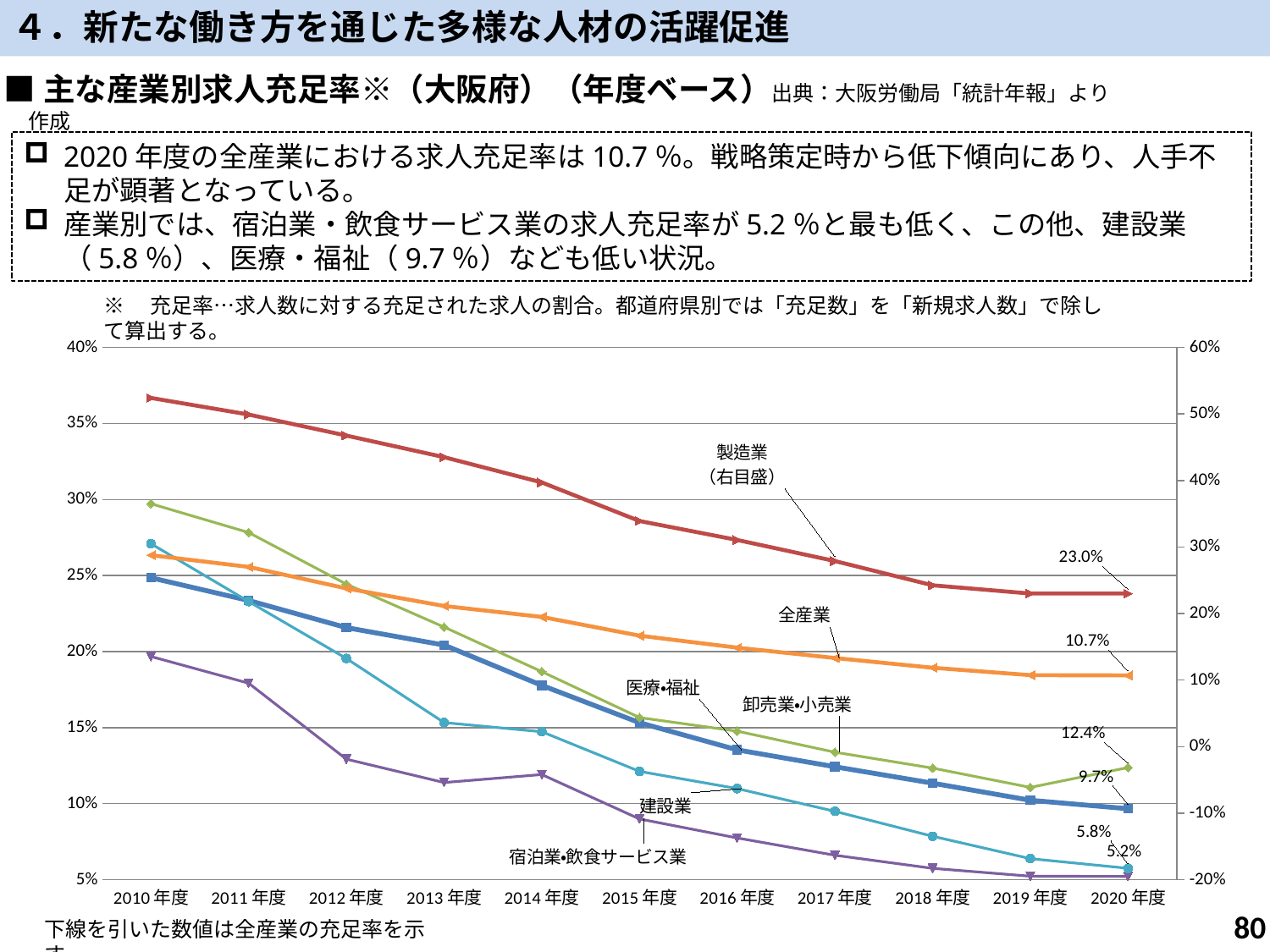
What is the value for 製造業 in 2020年度? 23.0% What is the difference between the 2020年度 values for 建設業 and 宿泊業・飲食サービス業? 0.6% What kind of chart is shown on the slide? line chart Which industry has the lowest value in 2020年度? 宿泊業・飲食サービス業 What is the value for 宿泊業・飲食サービス業 in 2020年度? 5.2% What is the value for 全産業 in 2020年度? 10.7% What is the value for 卸売業・小売業 in 2020年度? 12.4% What is the value for 建設業 in 2020年度? 5.8% What is the value for 医療・福祉 in 2020年度? 9.7% Which series is plotted against the right-hand axis (右目盛)? 製造業 How many fiscal years are plotted along the x axis? 11 Does the 製造業 line rise or fall from 2010年度 to 2020年度? fall